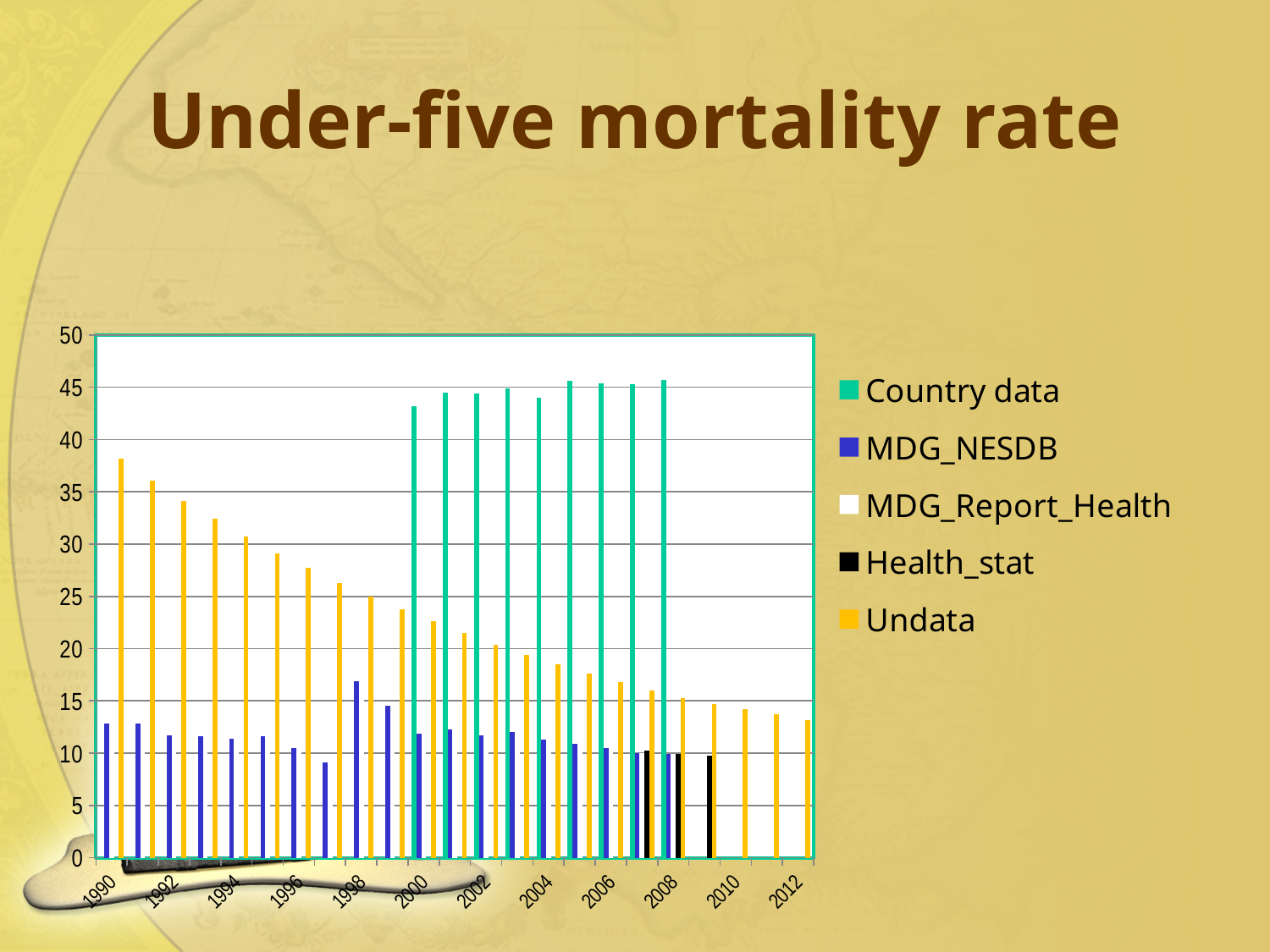
Which series has the tallest bars on the chart? Country data Is the MDG_NESDB value for 1998 greater or less than 15? greater How many series does the legend list? 5 Is the Country data value for 2000 greater or less than 40? greater Do the Undata values rise or fall from 1990 to 2012? fall Is the Undata value for 1990 greater or less than 35? greater What kind of chart is shown on the slide? bar chart Which is larger in 2000, the Country data value or the Undata value? Country data Which series is shown in black in the legend? Health_stat In which year is the Undata value highest? 1990 What is the title of the slide's chart? Under-five mortality rate